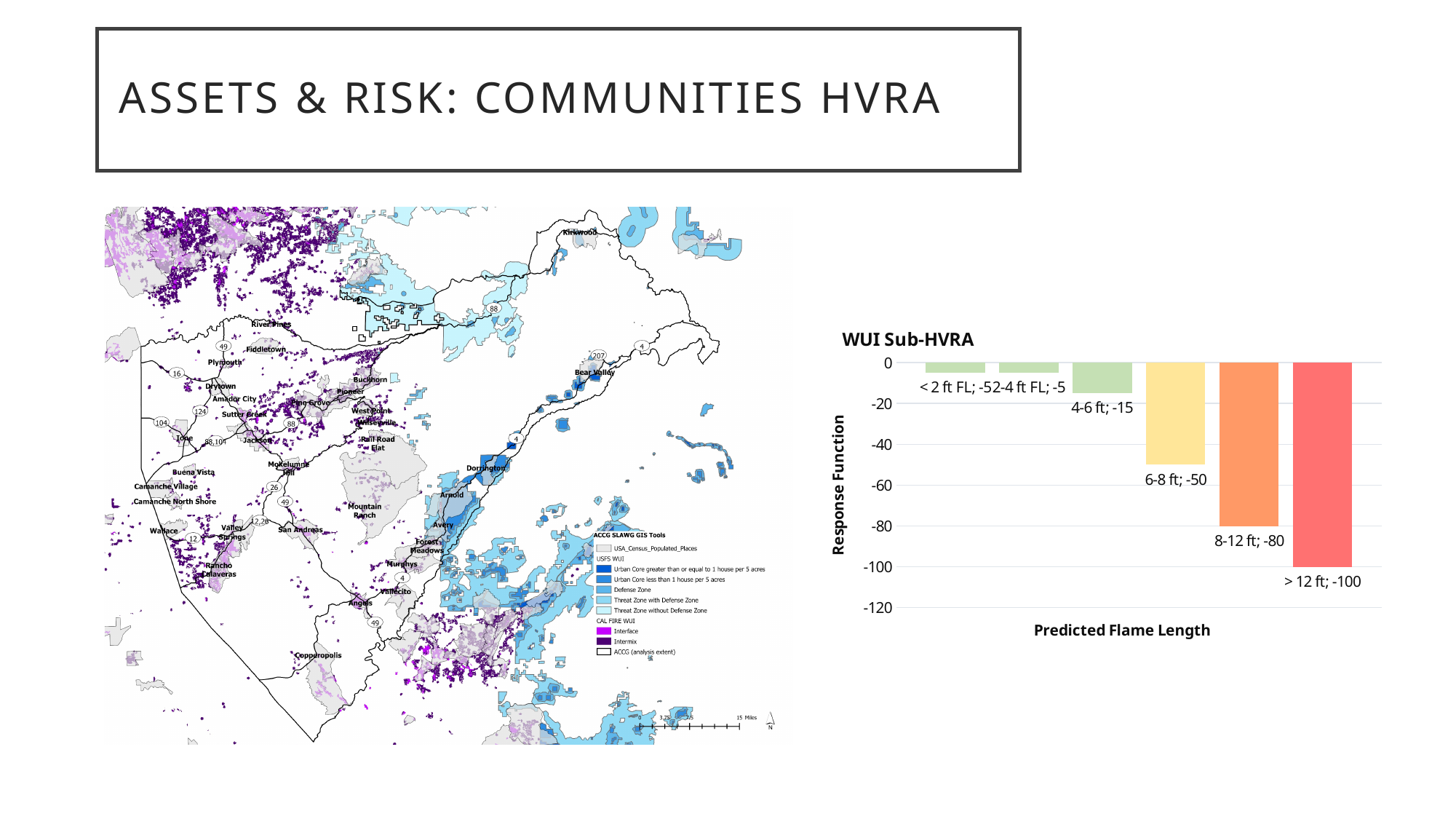
What is the label of the x axis in the WUI Sub-HVRA chart? Predicted Flame Length In the WUI Sub-HVRA chart, what is the difference between the response function values for 8-12 ft and 6-8 ft? 30 In the WUI Sub-HVRA chart, what is the response function value for the 4-6 ft flame length category? -15 In the WUI Sub-HVRA chart, which has the more negative response function value, 4-6 ft or 6-8 ft? 6-8 ft How many flame length categories are plotted in the WUI Sub-HVRA chart? 6 In the WUI Sub-HVRA chart, what is the response function value for the 6-8 ft flame length category? -50 In the WUI Sub-HVRA chart, what is the response function value for the > 12 ft flame length category? -100 What kind of chart is the WUI Sub-HVRA chart? Bar chart In the WUI Sub-HVRA chart, which flame length category has the lowest (most negative) response function value? > 12 ft In the WUI Sub-HVRA chart, what is the response function value for the 8-12 ft flame length category? -80 What is the label of the y axis in the WUI Sub-HVRA chart? Response Function In the WUI Sub-HVRA chart, do the response function values rise or fall as predicted flame length increases along the x axis? Fall